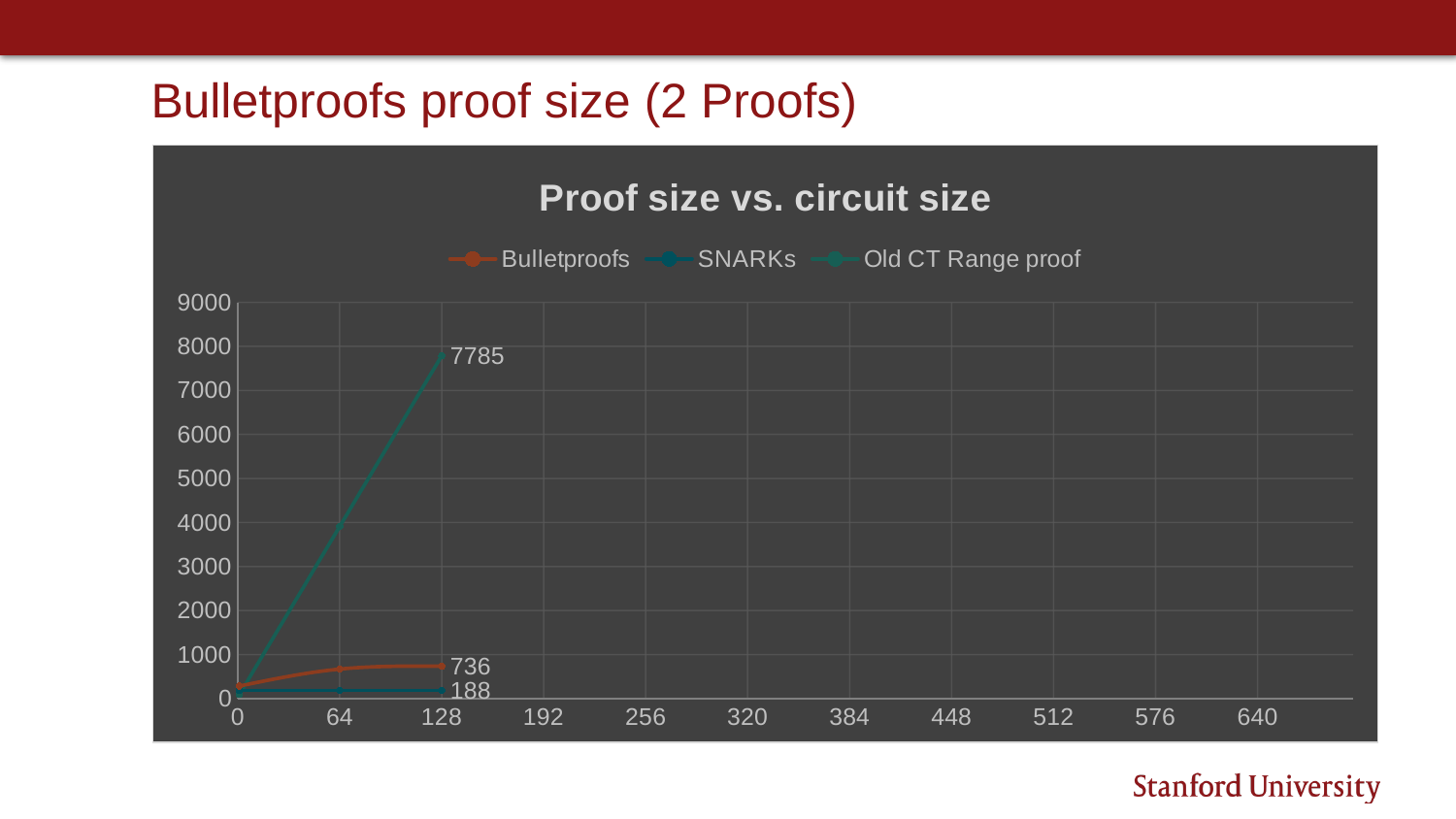
What is the difference between the Bulletproofs and SNARKs proof sizes at circuit size 128? 548 What is the proof size for Old CT Range proof at circuit size 128? 7785 How many series does the legend list? 3 What is the proof size for SNARKs at circuit size 128? 188 Which series has the smallest proof size at circuit size 128? SNARKs What is the title of the chart? Proof size vs. circuit size What kind of chart is shown on the slide? line chart Is the value for Old CT Range proof at circuit size 64 greater or less than 3000? greater Which series has the largest proof size at circuit size 128? Old CT Range proof Does the Old CT Range proof line rise or fall from circuit size 0 to 128? rise What is the proof size for Bulletproofs at circuit size 128? 736 What is the difference between the Old CT Range proof and Bulletproofs proof sizes at circuit size 128? 7049